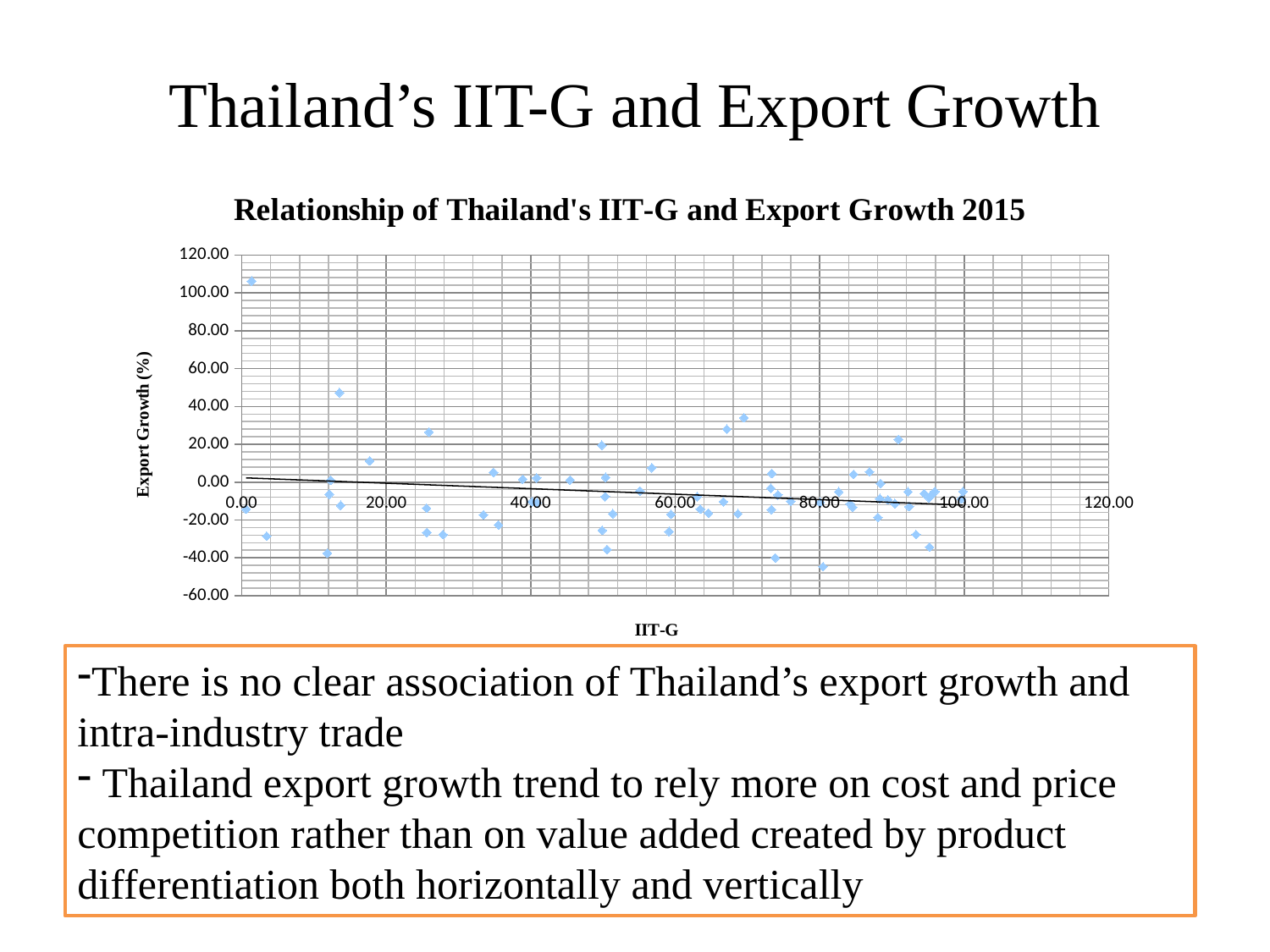
What is the title of the chart? Relationship of Thailand's IIT-G and Export Growth 2015 Does the fitted trend line in the chart rise or fall as IIT-G increases? Fall What kind of chart is shown on the slide? Scatter chart What label is shown on the vertical axis of the chart? Export Growth (%) Is the lowest export growth value plotted in the chart greater or less than -40? less What is the highest tick value shown on the vertical axis of the chart? 120.00 What is the lowest tick value shown on the vertical axis of the chart? -60.00 Is the highest export growth value plotted in the chart greater or less than 100? greater What is the highest tick value shown on the horizontal axis of the chart? 120.00 Is the second-highest export growth value plotted in the chart greater or less than 40? greater